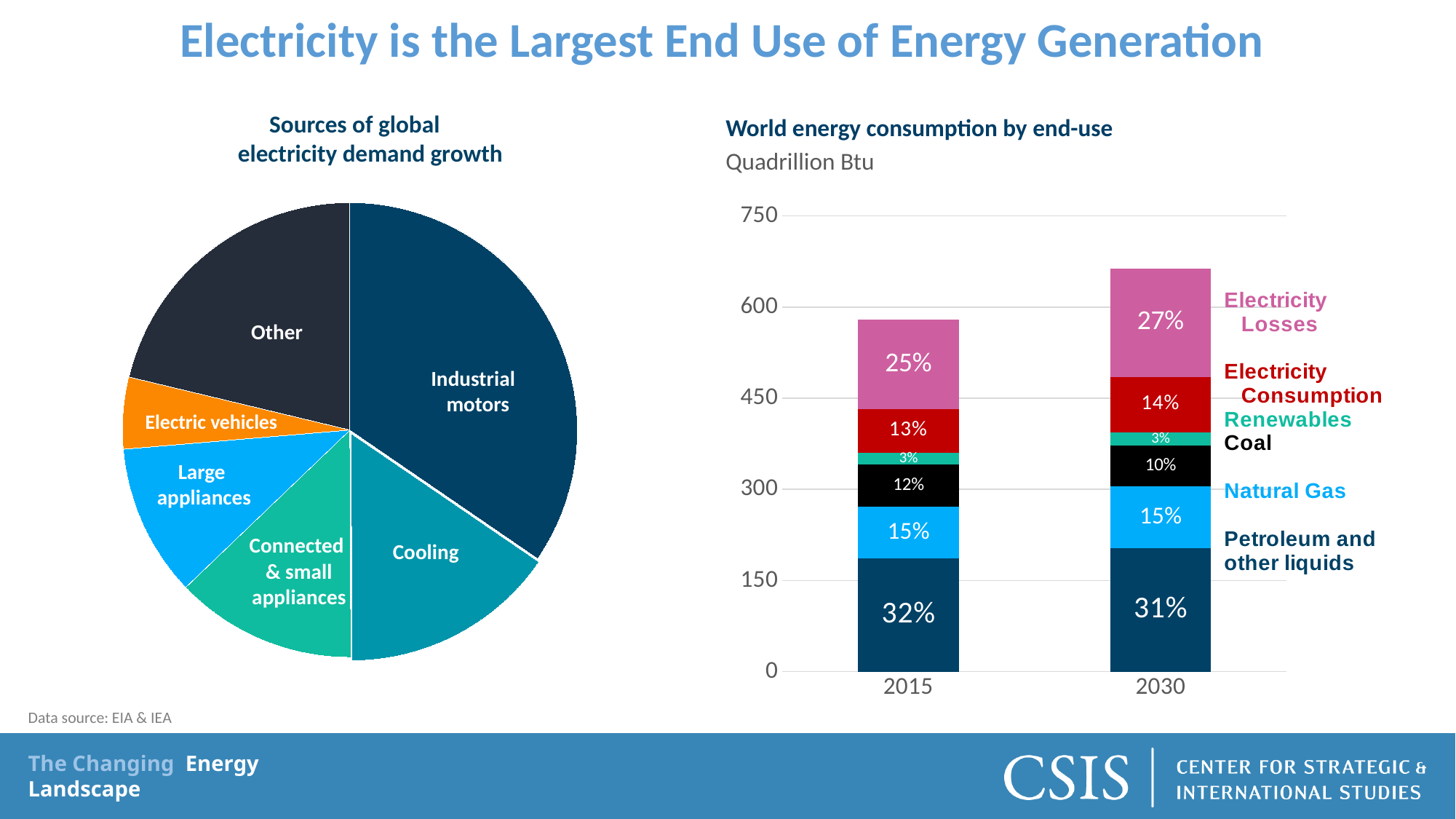
In the 'World energy consumption by end-use' chart, is the total for the 2030 bar greater or less than 600? greater In the 'Sources of global electricity demand growth' pie chart, which slice is the largest? Industrial motors What kind of chart is the 'World energy consumption by end-use' chart? stacked bar chart In the 'Sources of global electricity demand growth' pie chart, which slice is the smallest? Electric vehicles In the 'World energy consumption by end-use' chart, what is the Coal share for 2015? 12% In the 'World energy consumption by end-use' chart, which bar is taller, 2015 or 2030? 2030 How many slices does the 'Sources of global electricity demand growth' pie chart have? 6 In the 'World energy consumption by end-use' chart, what is the Petroleum and other liquids share for 2015? 32% What kind of chart is the 'Sources of global electricity demand growth' chart? pie chart In the 'World energy consumption by end-use' chart, what is the Electricity Losses share for 2030? 27% In the 'World energy consumption by end-use' chart, how many series does the legend list? 6 In the 'World energy consumption by end-use' chart, by how many percentage points does the Coal share fall from 2015 to 2030? 2